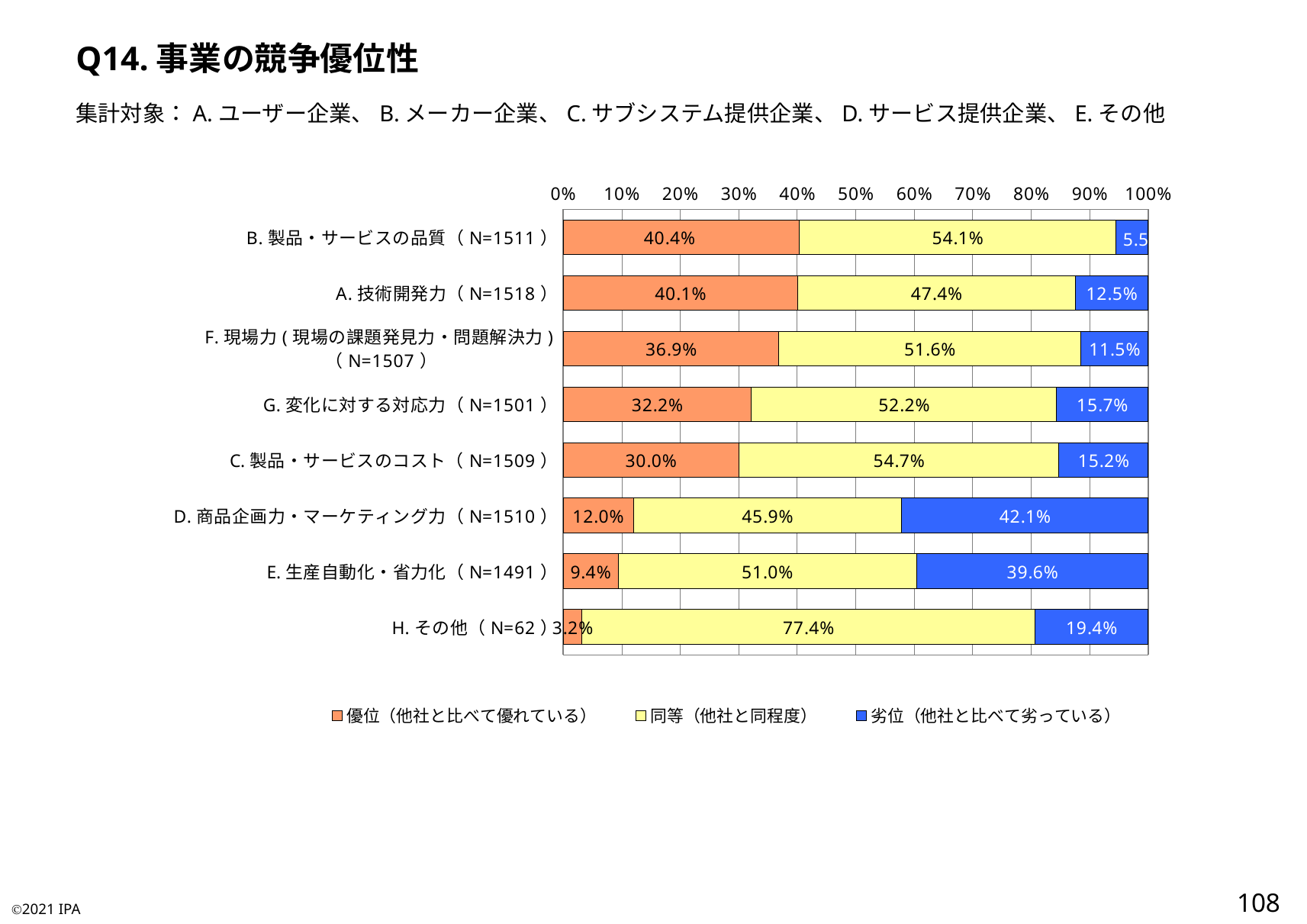
What kind of chart is shown on the slide? stacked bar chart What is the 同等 value for H. その他 (N=62)? 77.4% How many categories are plotted in the chart? 8 Which category has the lowest 優位 value? H. その他 (N=62) How many series does the legend list? 3 Which category has the highest 優位 value? B. 製品・サービスの品質 (N=1511) What is the 劣位 value for D. 商品企画力・マーケティング力 (N=1510)? 42.1% What is the 優位 value for A. 技術開発力 (N=1518)? 40.1% Which category has the highest 劣位 value? D. 商品企画力・マーケティング力 (N=1510) What is the difference between the 劣位 values for D. 商品企画力・マーケティング力 and E. 生産自動化・省力化? 2.5% Which is larger, the 同等 value for C. 製品・サービスのコスト or for G. 変化に対する対応力? C. 製品・サービスのコスト Which legend entry is shown in blue? 劣位（他社と比べて劣っている）